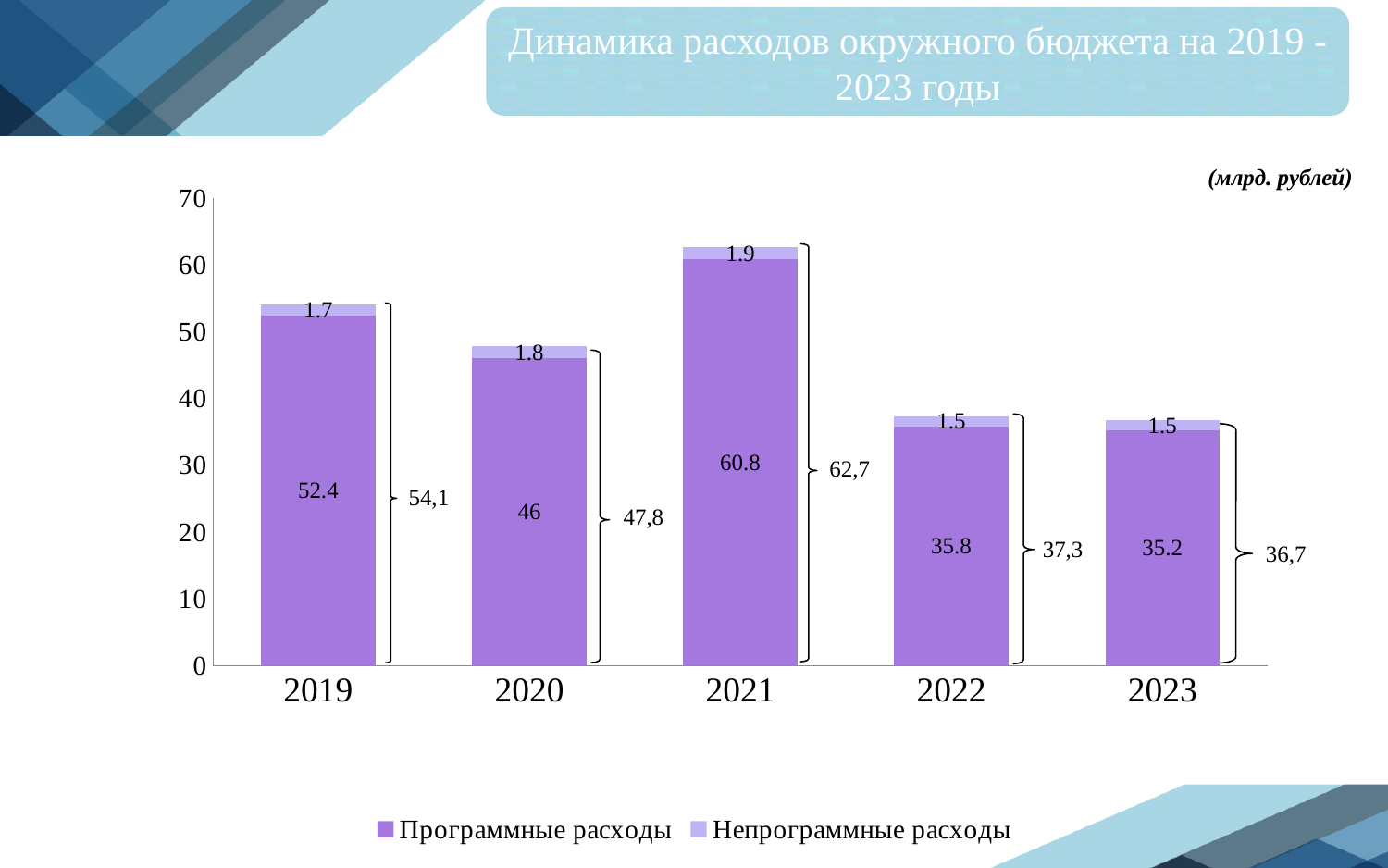
What is the value of Программные расходы for 2021? 60.8 Which is larger, Непрограммные расходы in 2019 or in 2022? 2019 What is the value of Непрограммные расходы for 2020? 1.8 Which year has the highest Программные расходы? 2021 What is the difference between Программные расходы in 2021 and 2020? 14.8 What is the value of Программные расходы for 2023? 35.2 How many series does the legend list? 2 What is the total of the stacked bar for 2019? 54,1 Which year has the lowest Программные расходы? 2023 What type of chart is shown on the slide? Stacked bar chart What is the total of the stacked bar for 2022? 37,3 How many years are shown on the x axis? 5